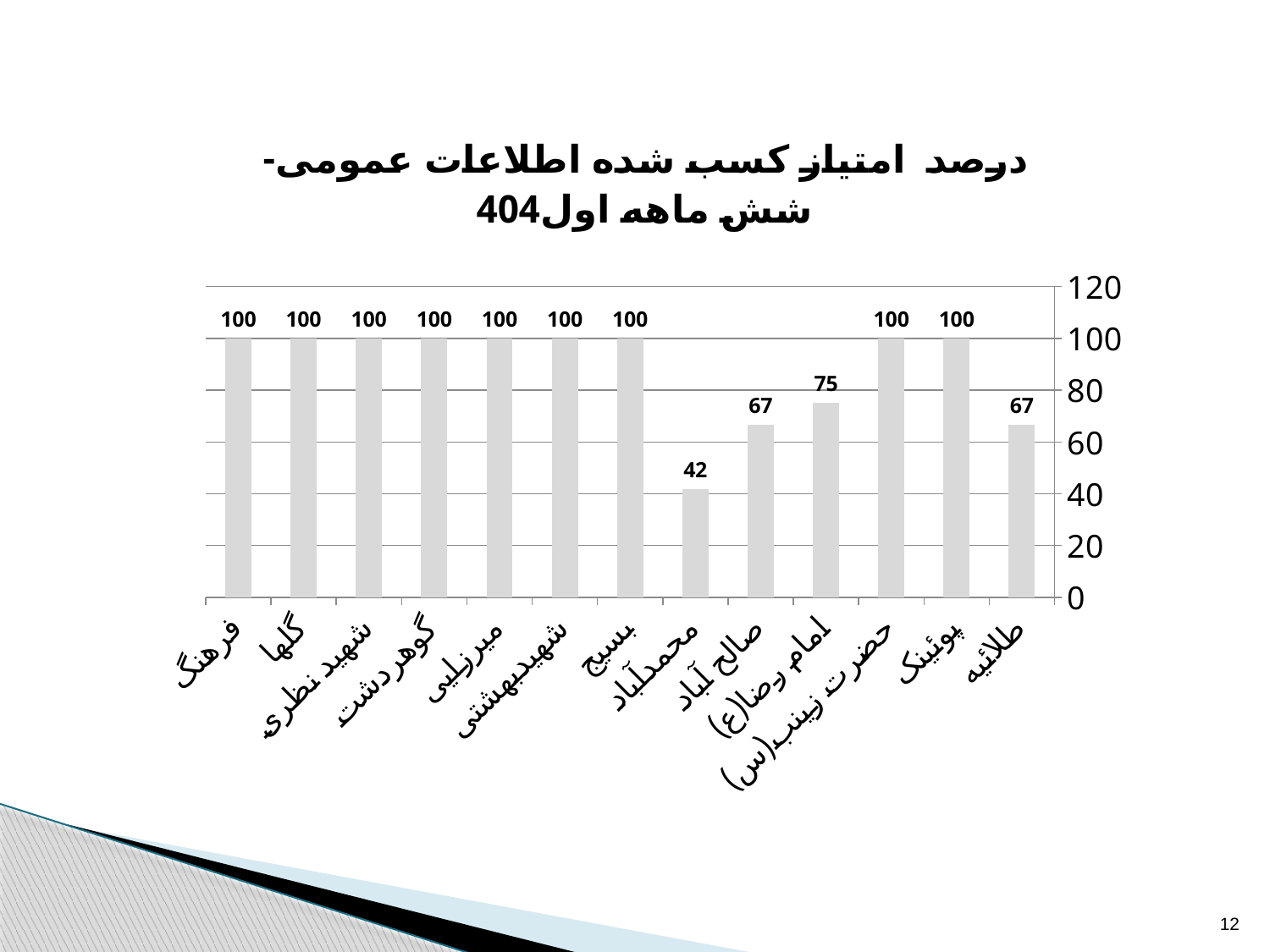
What is the value for طلائیه? 67 What type of chart is shown on the slide? bar chart Is the value for محمدآباد greater or less than 60? less How many categories are plotted in the chart? 13 What is the value for امام رضا(ع)? 75 What is the value for پوئینک? 100 What is the difference between the values for امام رضا(ع) and محمدآباد? 33 Which is larger, the value for صالح آباد or the value for امام رضا(ع)? امام رضا(ع) What is the value for محمدآباد? 42 What is the value for صالح آباد? 67 Which category has the lowest value? محمدآباد How many categories have a value of 100? 9